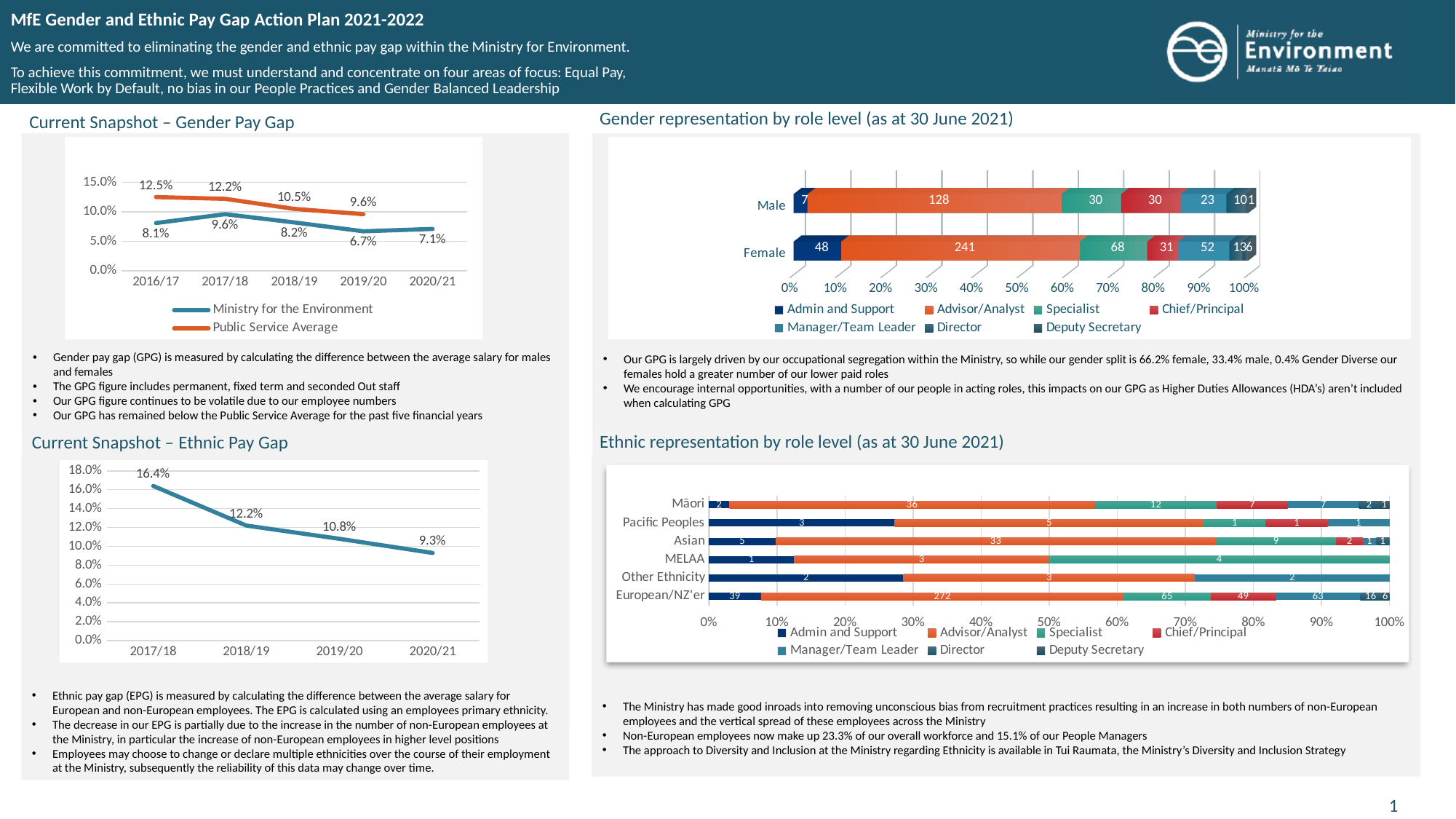
In the Current Snapshot – Gender Pay Gap chart, what was the Public Service Average in 2016/17? 12.5% In the Current Snapshot – Ethnic Pay Gap chart, do the values rise or fall from 2017/18 to 2020/21? fall In the Ethnic representation by role level chart, which ethnicity has the largest number of Advisor/Analyst staff? European/NZ'er How many years are shown on the x axis of the Current Snapshot – Ethnic Pay Gap chart? 4 In the Current Snapshot – Gender Pay Gap chart, what is the difference between the Public Service Average and the Ministry for the Environment in 2018/19? 2.3% In the Ethnic representation by role level chart, how many European/NZ'er Director staff are there? 16 How many series does the legend of the Current Snapshot – Gender Pay Gap chart list? 2 What kind of chart is the Current Snapshot – Ethnic Pay Gap chart? line chart In the Current Snapshot – Ethnic Pay Gap chart, what was the ethnic pay gap in 2017/18? 16.4% In the Gender representation by role level chart, how many Male Specialist staff are there? 30 In the Gender representation by role level chart, how many Female Advisor/Analyst staff are there? 241 In the Current Snapshot – Gender Pay Gap chart, what was the Ministry for the Environment's gender pay gap in 2019/20? 6.7%